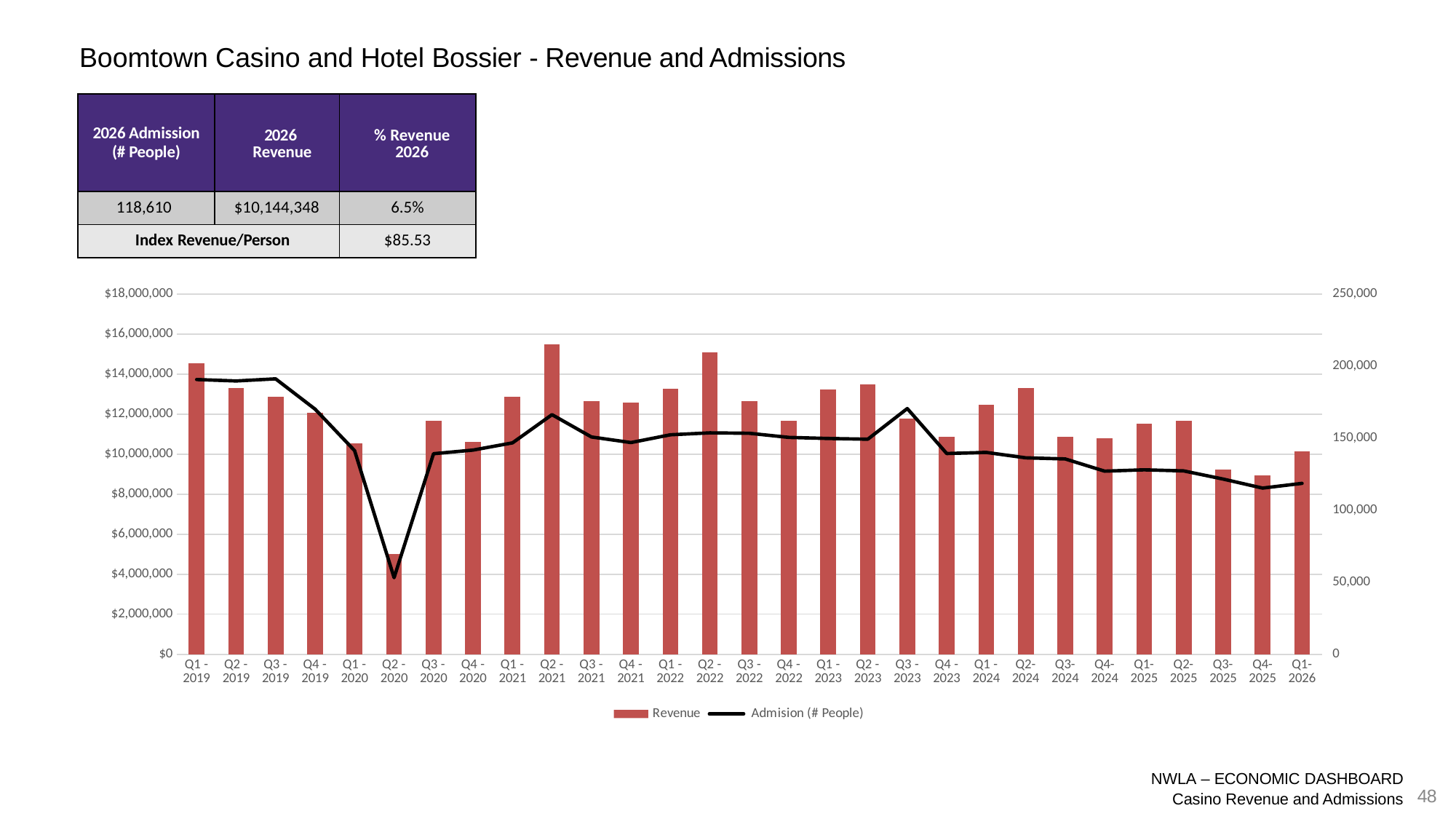
Which quarter has the highest Revenue bar? Q2 - 2021 What kind of chart is shown on the slide? Combination bar and line chart Which quarter has the lowest Revenue bar? Q2 - 2020 How many quarters are plotted along the x axis of the chart? 29 Is the Revenue for Q2 - 2020 greater or less than $6,000,000? less Does the Admision (# People) line generally rise or fall from Q3 - 2023 to Q4 - 2025? fall Is the Admision (# People) value for Q2 - 2020 greater or less than 100,000? less Is the Revenue for Q1 - 2019 greater or less than $14,000,000? greater In which quarter does the Admision (# People) line reach its lowest point? Q2 - 2020 How many series does the chart legend list? 2 Which quarter has the larger Revenue bar, Q1 - 2019 or Q1 - 2026? Q1 - 2019 What are the two series named in the chart legend? Revenue and Admision (# People)